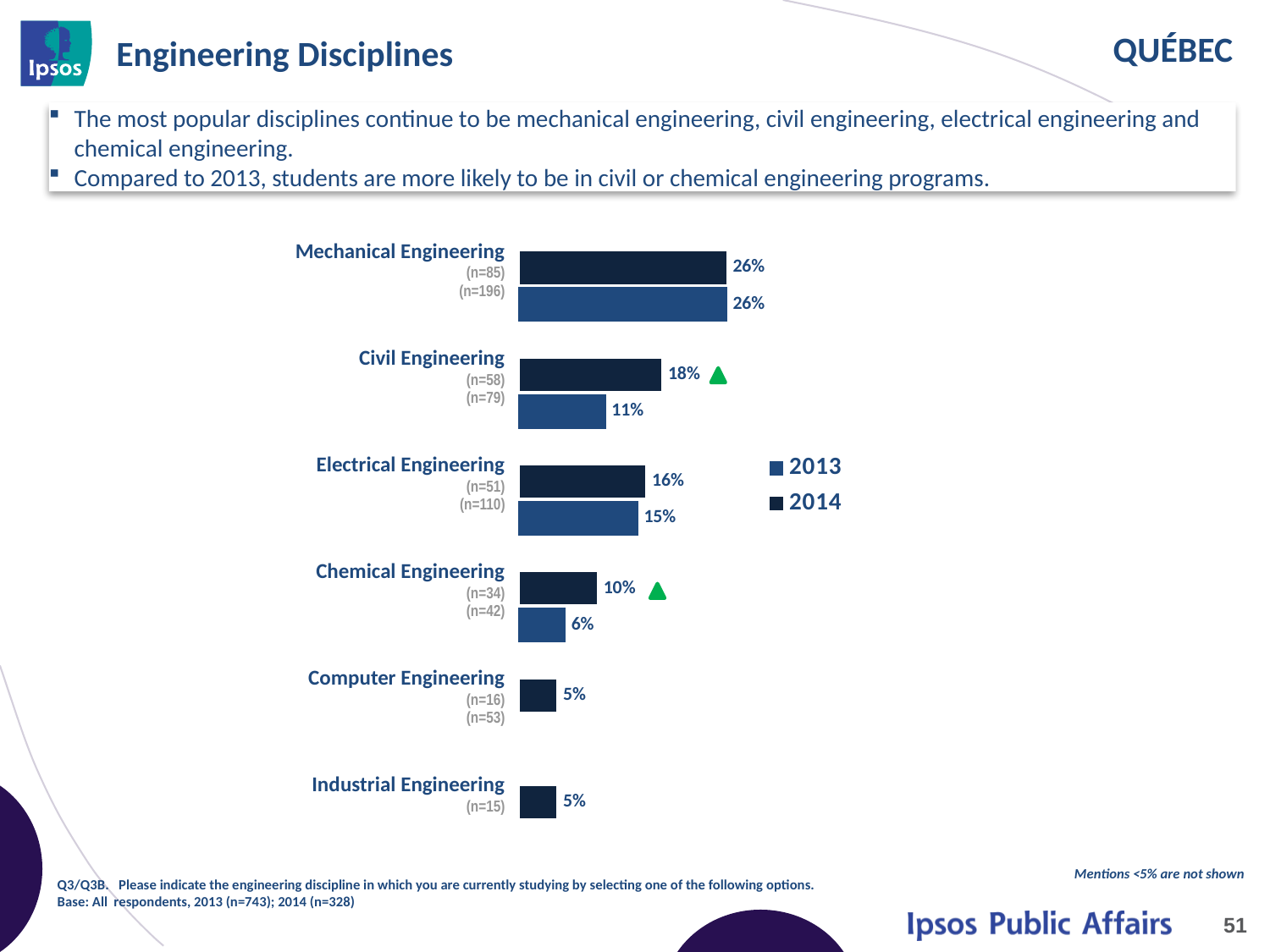
What is the 2014 value for Civil Engineering? 18% How many engineering disciplines are listed on the chart? 6 Which discipline has the highest 2014 value? Mechanical Engineering What is the 2013 value for Chemical Engineering? 6% What is the 2014 value for Industrial Engineering? 5% What kind of chart is shown on the slide? bar chart What is the difference between the 2014 and 2013 values for Civil Engineering? 7% How many series does the legend list? 2 Which series is shown in the darker navy colour in the legend? 2014 Which is larger, the 2014 value for Chemical Engineering or the 2014 value for Computer Engineering? Chemical Engineering Which discipline has the lowest 2013 value shown? Chemical Engineering What is the 2013 value for Electrical Engineering? 15%